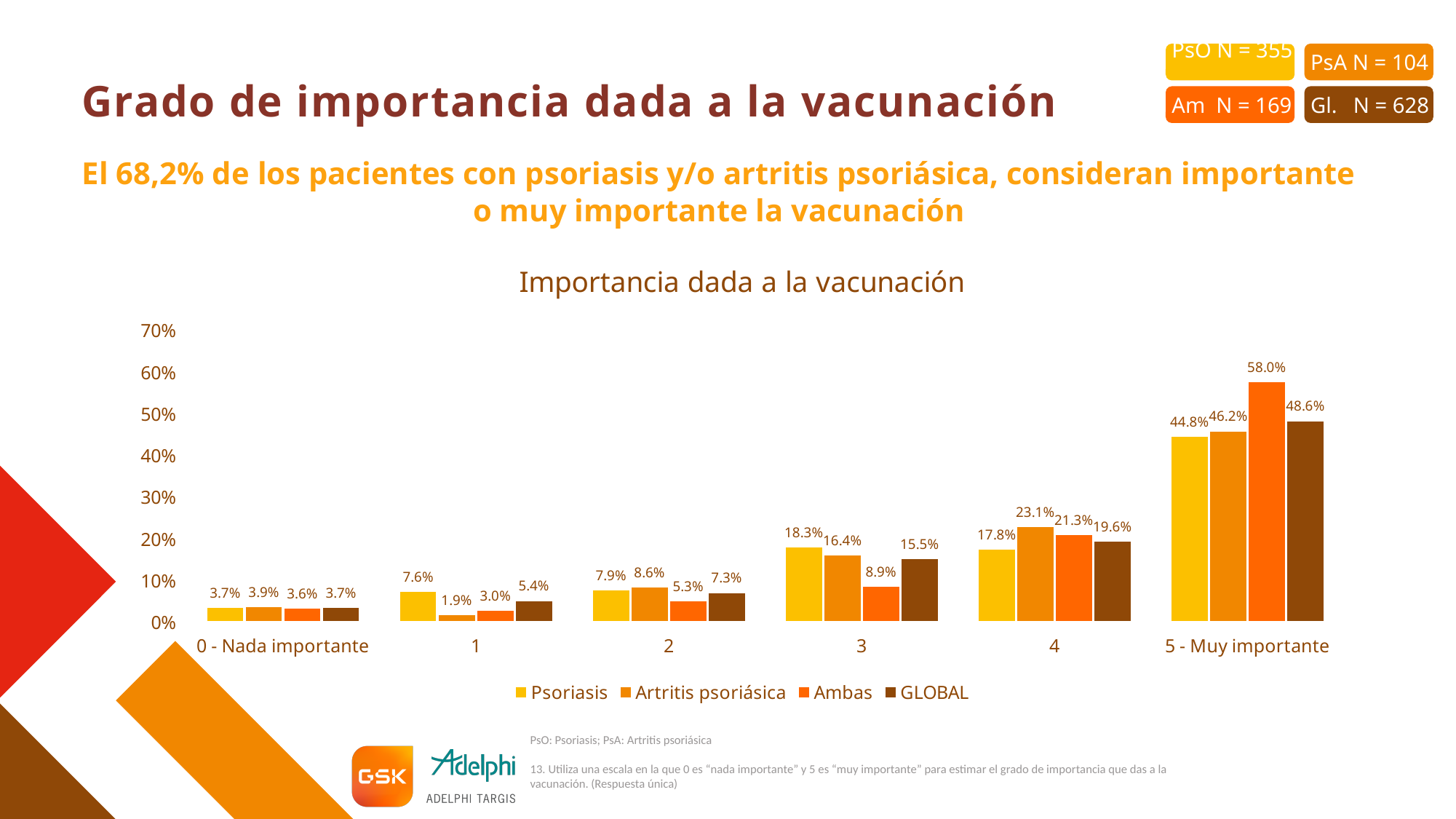
What is the title of the chart? Importancia dada a la vacunación Which category has the highest value for the Psoriasis series? 5 - Muy importante Is the GLOBAL value for '5 - Muy importante' greater or less than 40%? greater What is the difference between the Ambas and Psoriasis values in the '5 - Muy importante' category? 13.2% What kind of chart is shown on the slide? Bar chart How many categories are shown on the x axis? 6 What is the GLOBAL value for category 3? 15.5% What is the value for Ambas in the '5 - Muy importante' category? 58.0% How many series does the legend list? 4 Which is larger in category 4: the Artritis psoriásica value or the Ambas value? Artritis psoriásica What is the value for Artritis psoriásica in category 1? 1.9% Which series has the lowest value in category 1? Artritis psoriásica